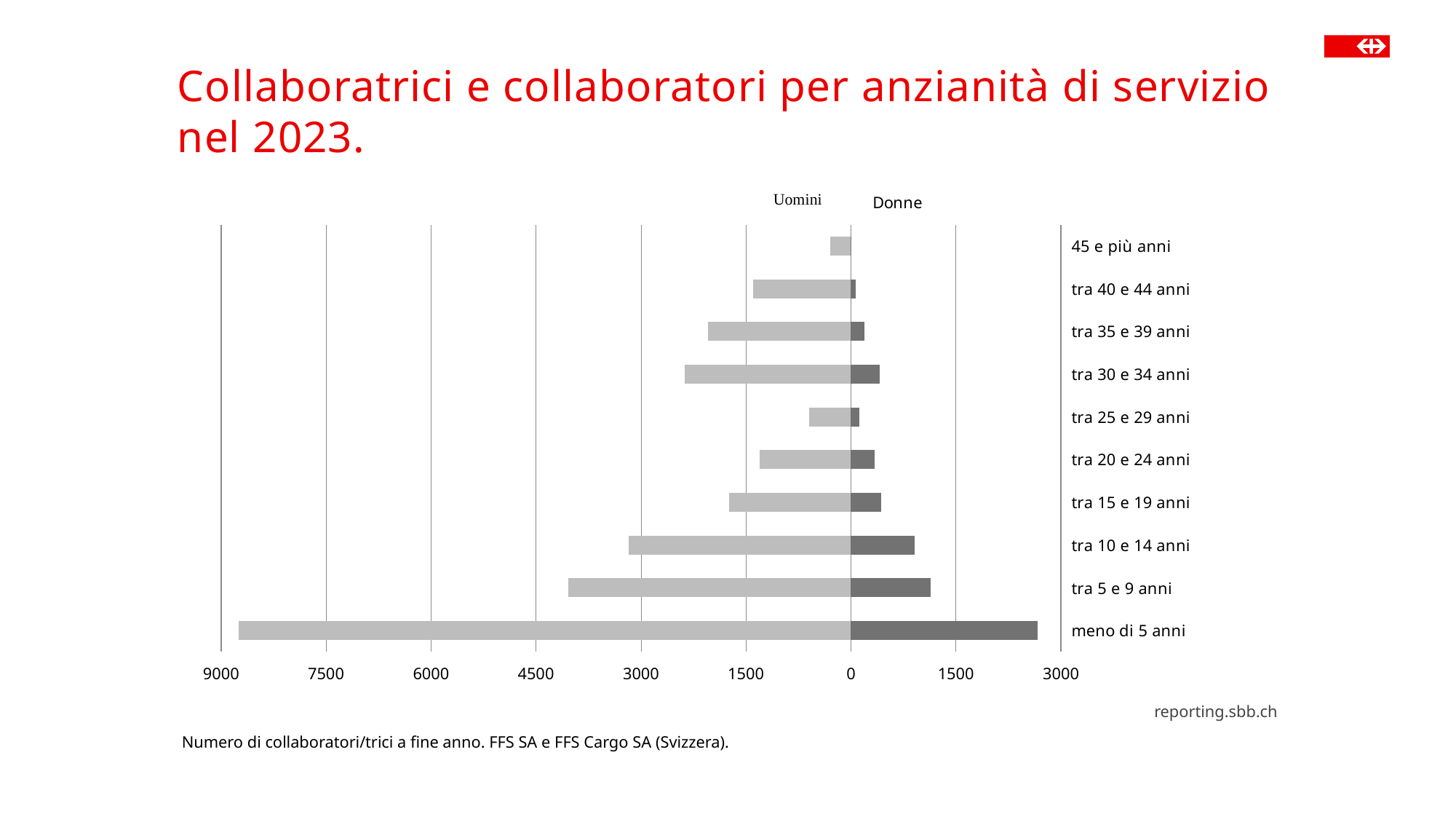
Is the Uomini value for 'tra 25 e 29 anni' greater or less than 1500? less Which series is plotted on the left side of the zero axis? Uomini What kind of chart is shown on the slide? bar chart Is the Donne value for 'meno di 5 anni' greater or less than 1500? greater Which seniority category has the highest value for Uomini? meno di 5 anni How many service-seniority categories are shown on the chart? 10 Which seniority category has the lowest value for Uomini? 45 e più anni For Uomini, which is larger: 'tra 5 e 9 anni' or 'tra 10 e 14 anni'? tra 5 e 9 anni Which seniority category has the highest value for Donne? meno di 5 anni Is the Uomini value for 'tra 5 e 9 anni' greater or less than 3000? greater How many series does the chart show? 2